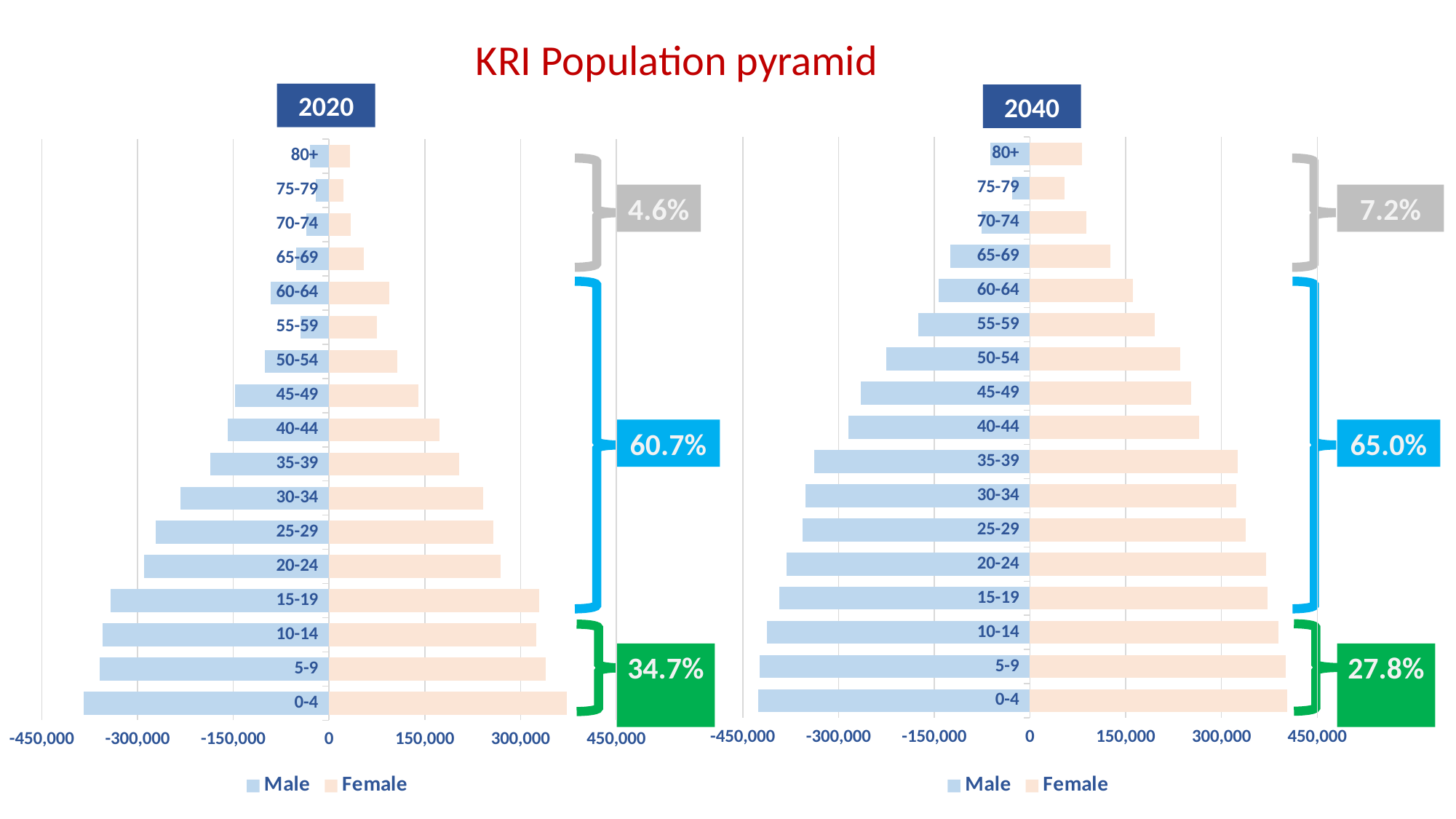
On the 2040 chart, what percentage is shown for the 15-64 age groups (blue label)? 65.0% What kind of chart is the 2020 chart on the slide? Bar chart What is the title of the slide's charts? KRI Population pyramid On the 2020 chart, which age group has the shortest Female bar? 75-79 On the 2040 chart, what percentage is shown for the 65+ age groups (grey label)? 7.2% On the 2020 chart, is the Female value for the 0-4 age group greater or less than 300,000? greater On the 2020 chart, what percentage is shown for the 0-14 age groups (green label)? 34.7% What is the difference between the 65+ share on the 2040 chart (7.2%) and on the 2020 chart (4.6%)? 2.6 percentage points How many series does the legend of the 2040 chart list? 2 On the 2020 chart, which is larger, the Female value for 35-39 or for 45-49? 35-39 How many age groups are shown on the 2020 chart? 17 On the 2040 chart, is the Female value for the 65-69 age group greater or less than 150,000? less